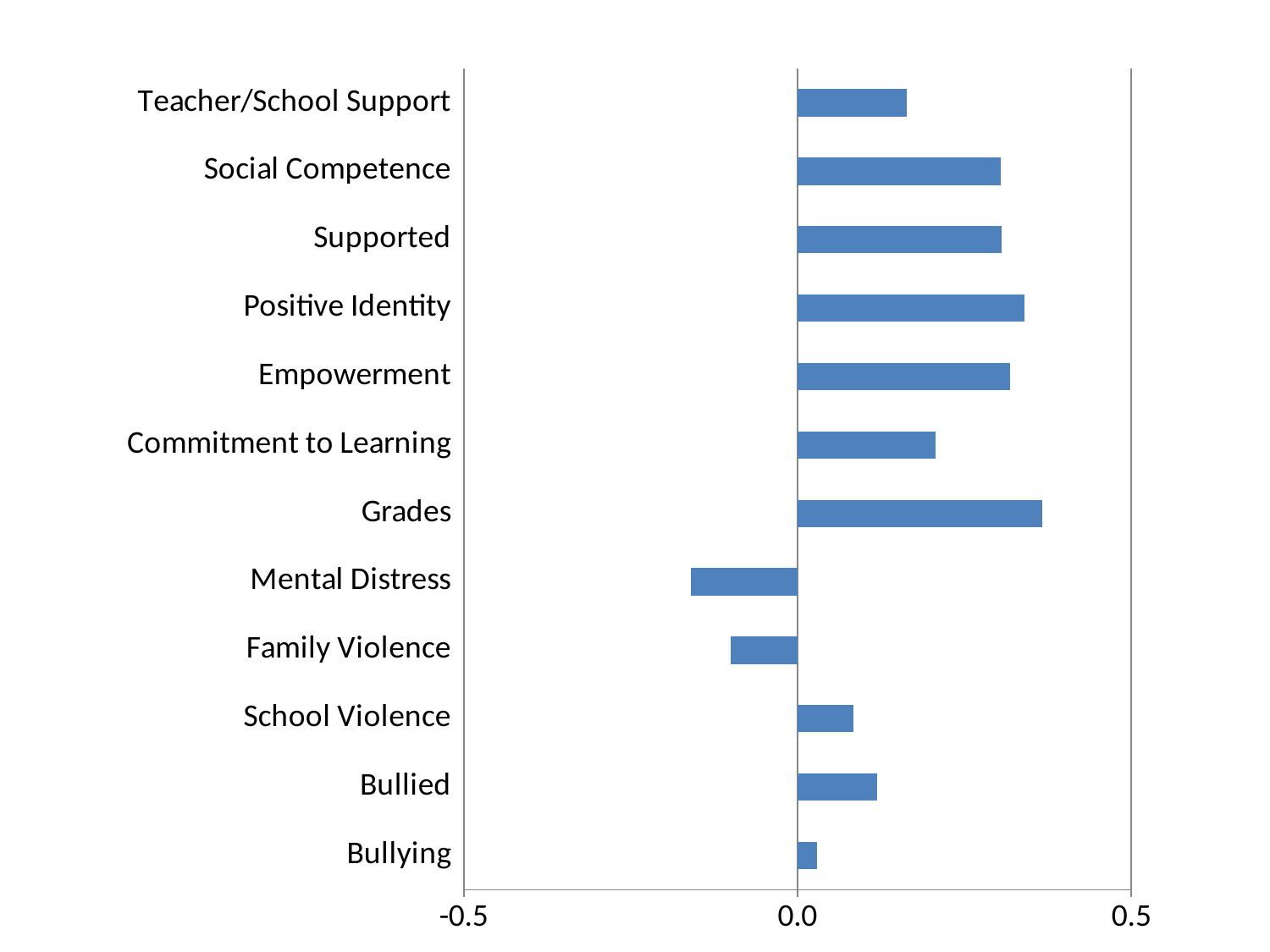
Is the value for Bullying greater or less than 0.0? greater What kind of chart is shown on the slide? bar chart Is the value for Family Violence greater or less than 0.0? less Is the value for Mental Distress greater or less than 0.0? less Which category has the highest value in the chart? Grades Which has the larger value, Grades or Bullying? Grades Which has the larger value, Empowerment or Commitment to Learning? Empowerment How many categories have a negative value (bar extending left of 0.0)? 2 What is the leftmost tick label on the horizontal axis? -0.5 Which category has the lowest value in the chart? Mental Distress How many categories are plotted in the chart? 12